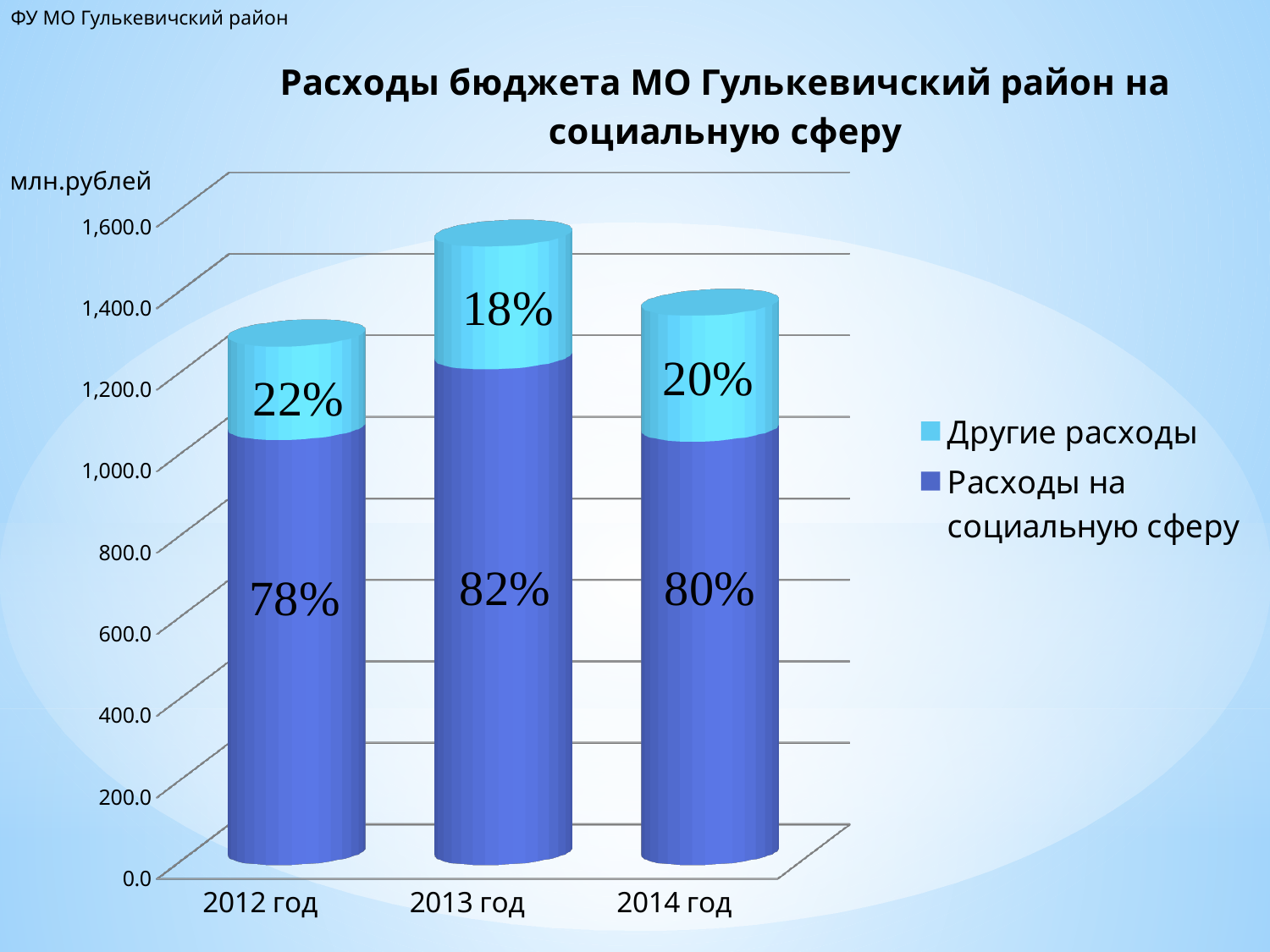
By how many percentage points does the 'Расходы на социальную сферу' share in 2013 exceed that in 2012? 4 Which is larger: the 'Другие расходы' share in 2012 or in 2014? 2012 год How many years are shown on the x axis? 3 What percentage label is shown for 'Другие расходы' in 2013? 18% Which year has the tallest total bar? 2013 год Is the total height of the 2013 bar greater or less than 1,400.0? greater What percentage of the 2012 bar is labelled for 'Расходы на социальную сферу'? 78% Which year has the lowest percentage share for 'Расходы на социальную сферу'? 2012 год What percentage label is shown for 'Расходы на социальную сферу' in 2014? 80% How many series does the legend list? 2 What unit is shown on the vertical axis? млн.рублей Which year has the highest percentage share for 'Расходы на социальную сферу'? 2013 год